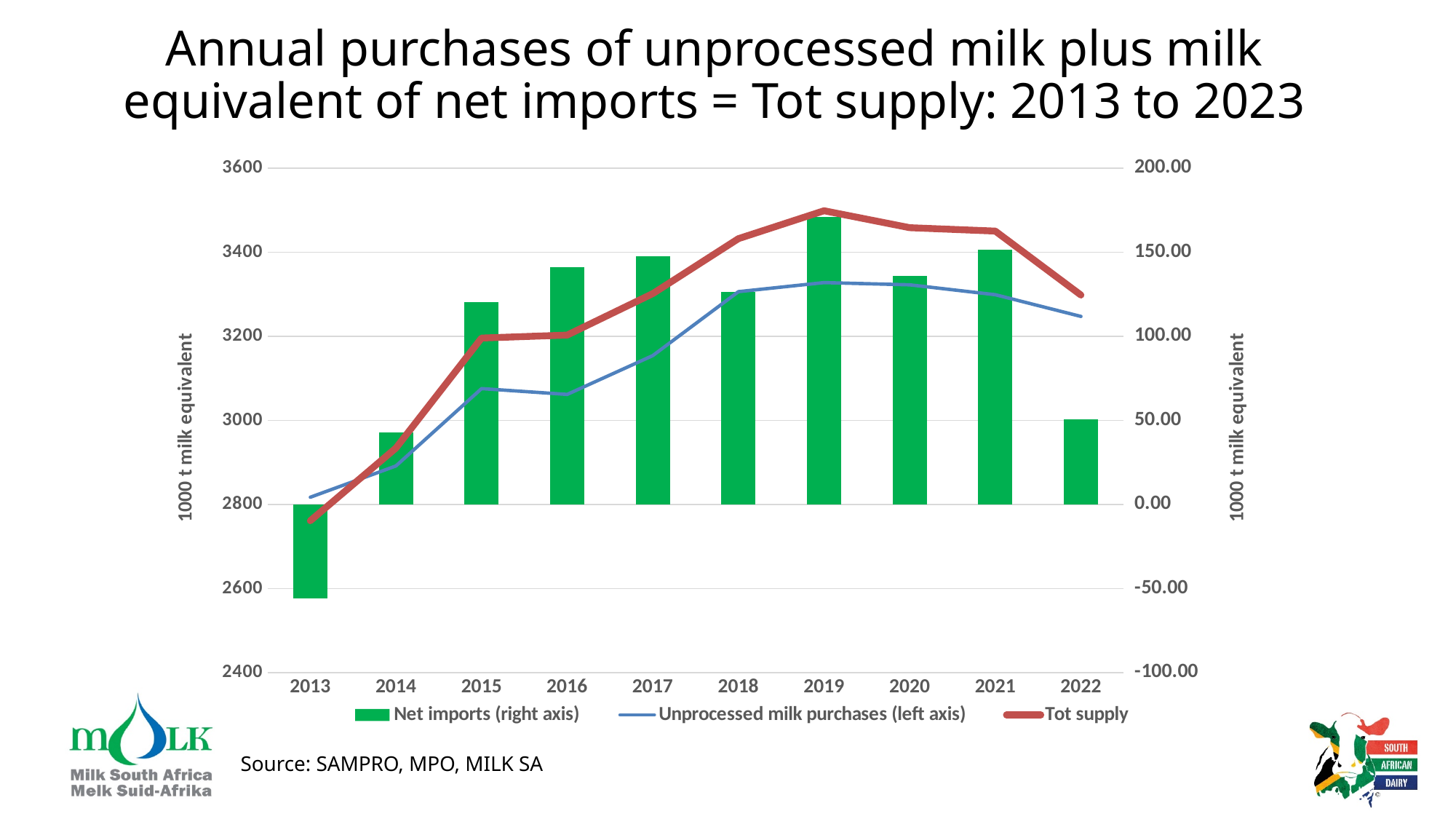
In which year are net imports lowest? 2013 Does Tot supply rise or fall from 2013 to 2019? rise What kind of chart is shown on the slide? Combined bar and line chart How many series does the legend list? 3 Is the value for net imports in 2019 greater or less than 150.00 on the right axis? greater Is the value for net imports in 2013 greater or less than 0.00 on the right axis? less Is the Tot supply value in 2022 greater or less than 3200 on the left axis? greater In which year does Tot supply reach its peak? 2019 In which year are net imports highest? 2019 How many years are shown on the x axis? 10 Which year has larger net imports, 2014 or 2016? 2016